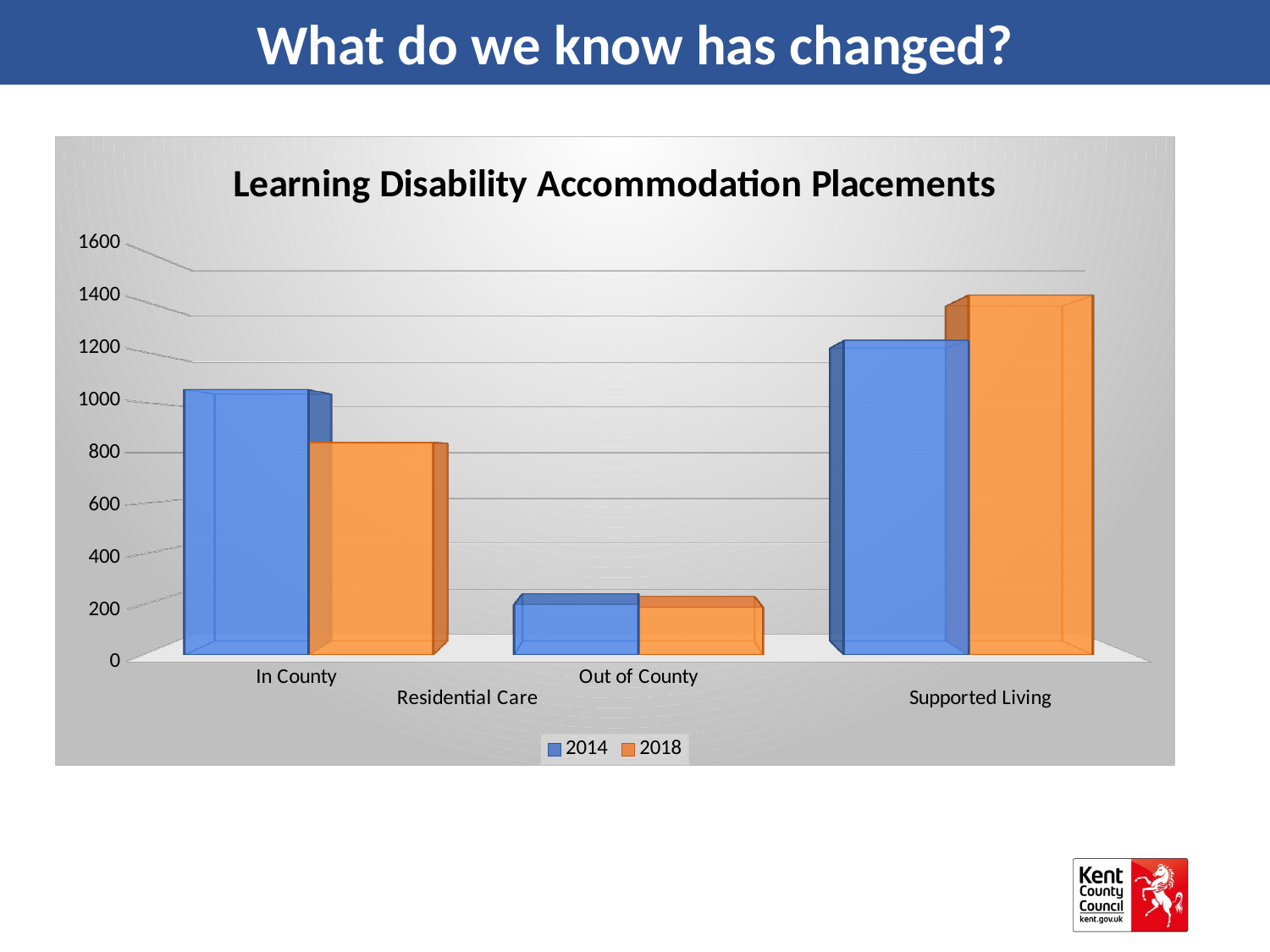
What type of chart is shown on the slide? Bar chart For Supported Living, which year has the larger value, 2014 or 2018? 2018 Is the 2018 value for In County greater or less than 1000? less Is the 2014 value for In County greater or less than 800? greater Which category has the lowest value for 2014? Out of County Is the 2014 value for Out of County greater or less than 400? less For In County, which year has the larger value, 2014 or 2018? 2014 What is the title of the chart? Learning Disability Accommodation Placements How many categories are shown on the x axis? 3 Which category has the highest bar in the chart? Supported Living How many series does the legend list? 2